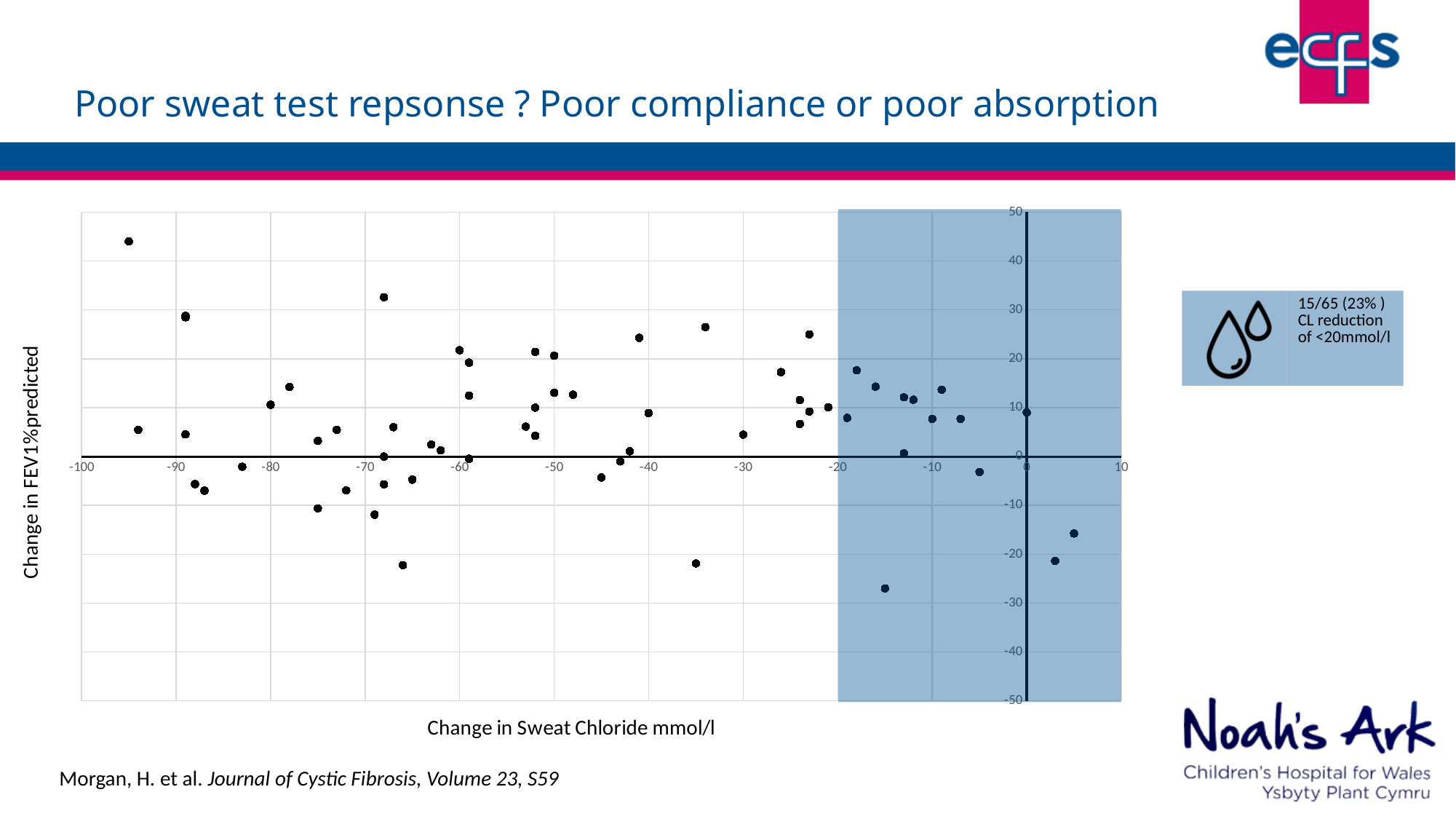
At which x-axis value does the shaded region of the chart begin? -20 What is the lowest value shown on the y axis? -50 What is the highest value shown on the x axis? 10 What is the highest value shown on the y axis? 50 What is the lowest value shown on the x axis? -100 According to the annotation beside the chart, how many of the 65 patients had a chloride reduction of less than 20 mmol/l? 15 What is the label of the x axis of the chart? Change in Sweat Chloride mmol/l What is the label of the y axis of the chart? Change in FEV1%predicted According to the annotation beside the chart, what percentage of patients had a chloride reduction of less than 20 mmol/l? 23% Is the lowest plotted change in FEV1%predicted greater or less than -20? less Is the highest plotted change in FEV1%predicted greater or less than 40? greater What kind of chart is shown on the slide? Scatter plot